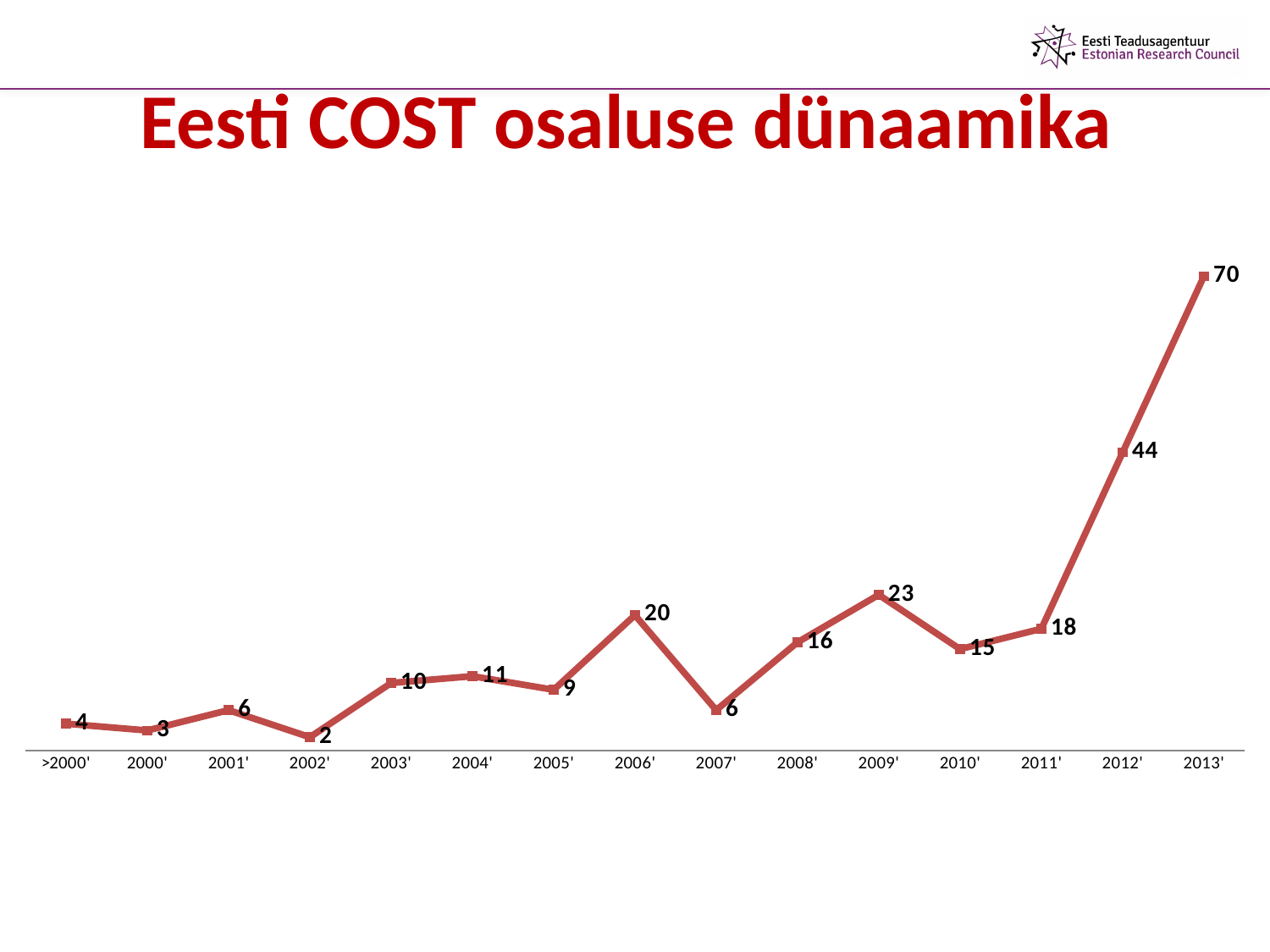
What is the value for 2006'? 20 Which category has the highest value? 2013' What kind of chart is shown on the slide? line chart Which category has the lowest value? 2002' What is the value for 2013'? 70 How many data points are plotted on the chart? 15 Do the values rise or fall from 2011' to 2013'? rise Which is larger, the value for 2006' or the value for 2007'? 2006' What is the title of the slide? Eesti COST osaluse dünaamika What is the difference between the values for 2009' and 2010'? 8 What is the value for 2002'? 2 What is the difference between the values for 2013' and 2012'? 26